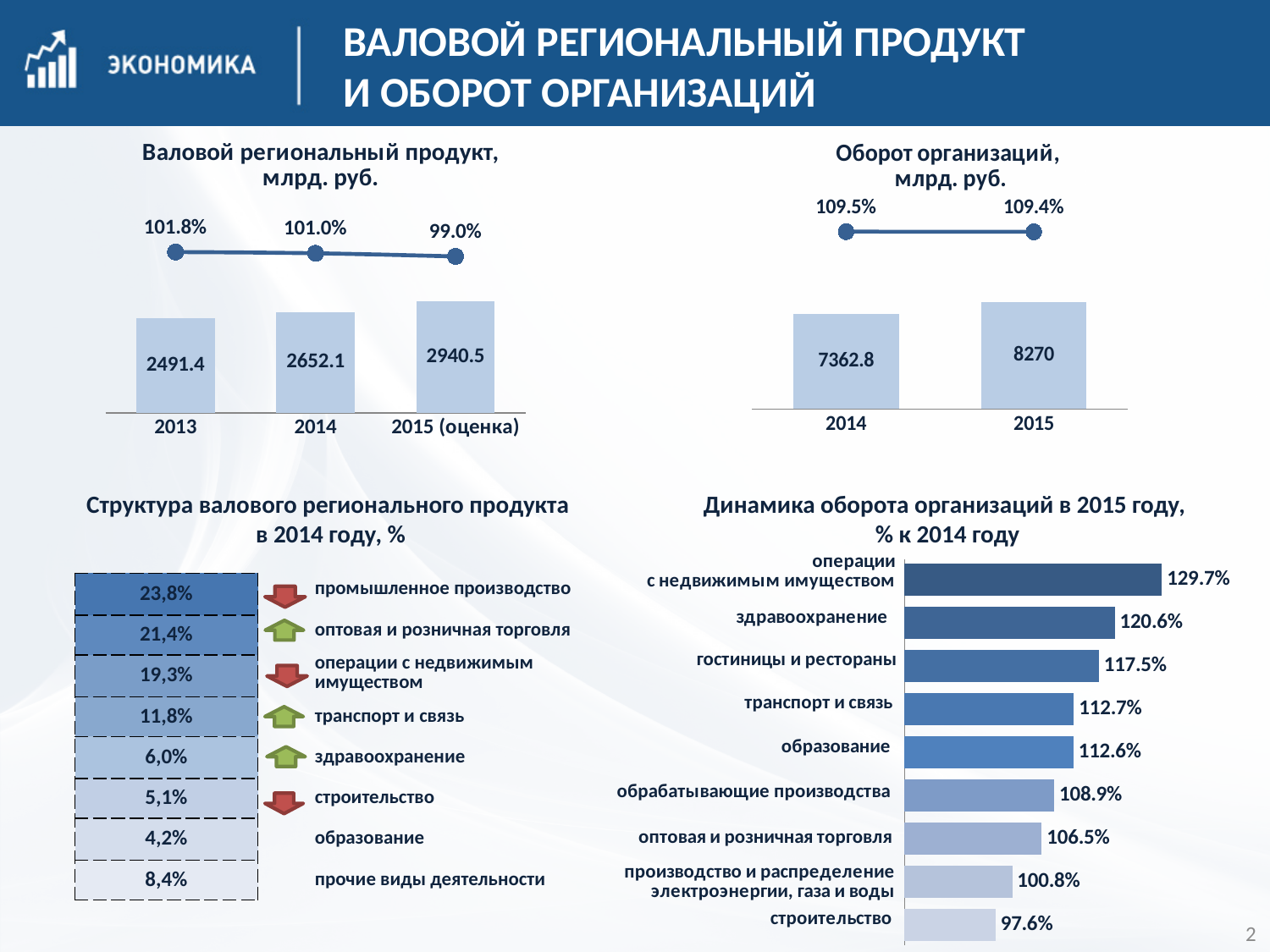
In the chart 'Динамика оборота организаций в 2015 году, % к 2014 году', how many categories are shown? 9 In the chart 'Валовой региональный продукт, млрд. руб.', what is the value for 2014? 2652.1 In the chart 'Динамика оборота организаций в 2015 году, % к 2014 году', which category has the lowest value? строительство In the chart 'Валовой региональный продукт, млрд. руб.', what is the percentage shown on the line for 2015 (оценка)? 99.0% In the chart 'Оборот организаций, млрд. руб.', what is the percentage shown on the line for 2014? 109.5% In the chart 'Оборот организаций, млрд. руб.', how many years are shown on the x axis? 2 In the chart 'Структура валового регионального продукта в 2014 году, %', which category has the largest share? промышленное производство In the chart 'Динамика оборота организаций в 2015 году, % к 2014 году', what is the value for гостиницы и рестораны? 117.5% In the chart 'Валовой региональный продукт, млрд. руб.', what is the difference between the 2015 (оценка) and 2013 bar values? 449.1 In the chart 'Валовой региональный продукт, млрд. руб.', do the bar values rise or fall from 2013 to 2015 (оценка)? rise In the chart 'Оборот организаций, млрд. руб.', what is the value for 2015? 8270 In the chart 'Структура валового регионального продукта в 2014 году, %', what is the share for транспорт и связь? 11,8%